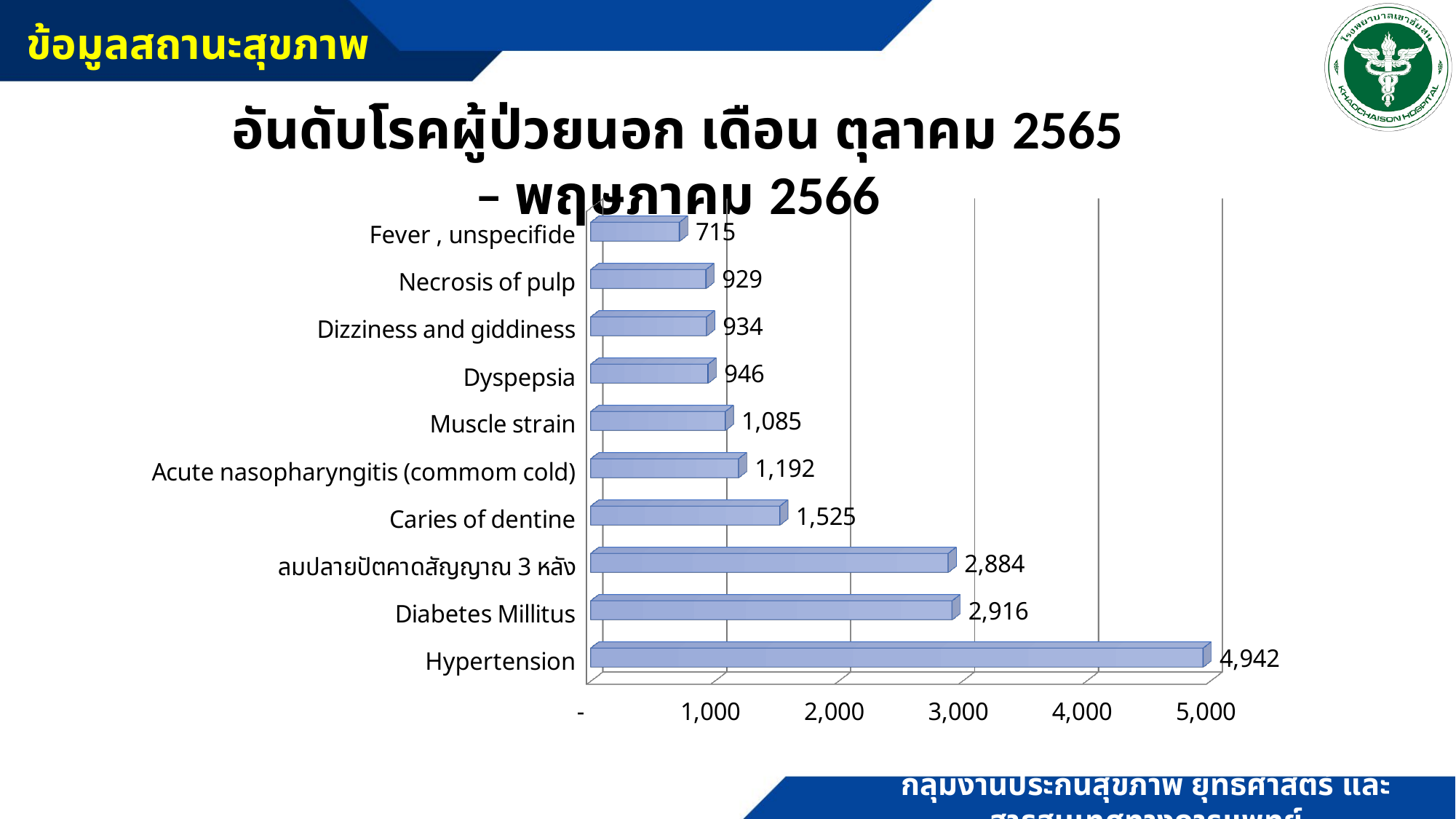
Which category has the highest value? Hypertension What kind of chart is shown on the slide? bar chart What is the value for Caries of dentine? 1,525 How many categories are shown in the chart? 10 What is the value for Acute nasopharyngitis (commom cold)? 1,192 What is the value for Hypertension? 4,942 Which category has the lowest value? Fever , unspecifide What is the value for Muscle strain? 1,085 Is the value for Hypertension greater or less than 4,000? greater Which is larger, the value for Caries of dentine or the value for Muscle strain? Caries of dentine What is the difference between the values for Hypertension and Diabetes Millitus? 2,026 What is the difference between the values for Caries of dentine and Fever , unspecifide? 810